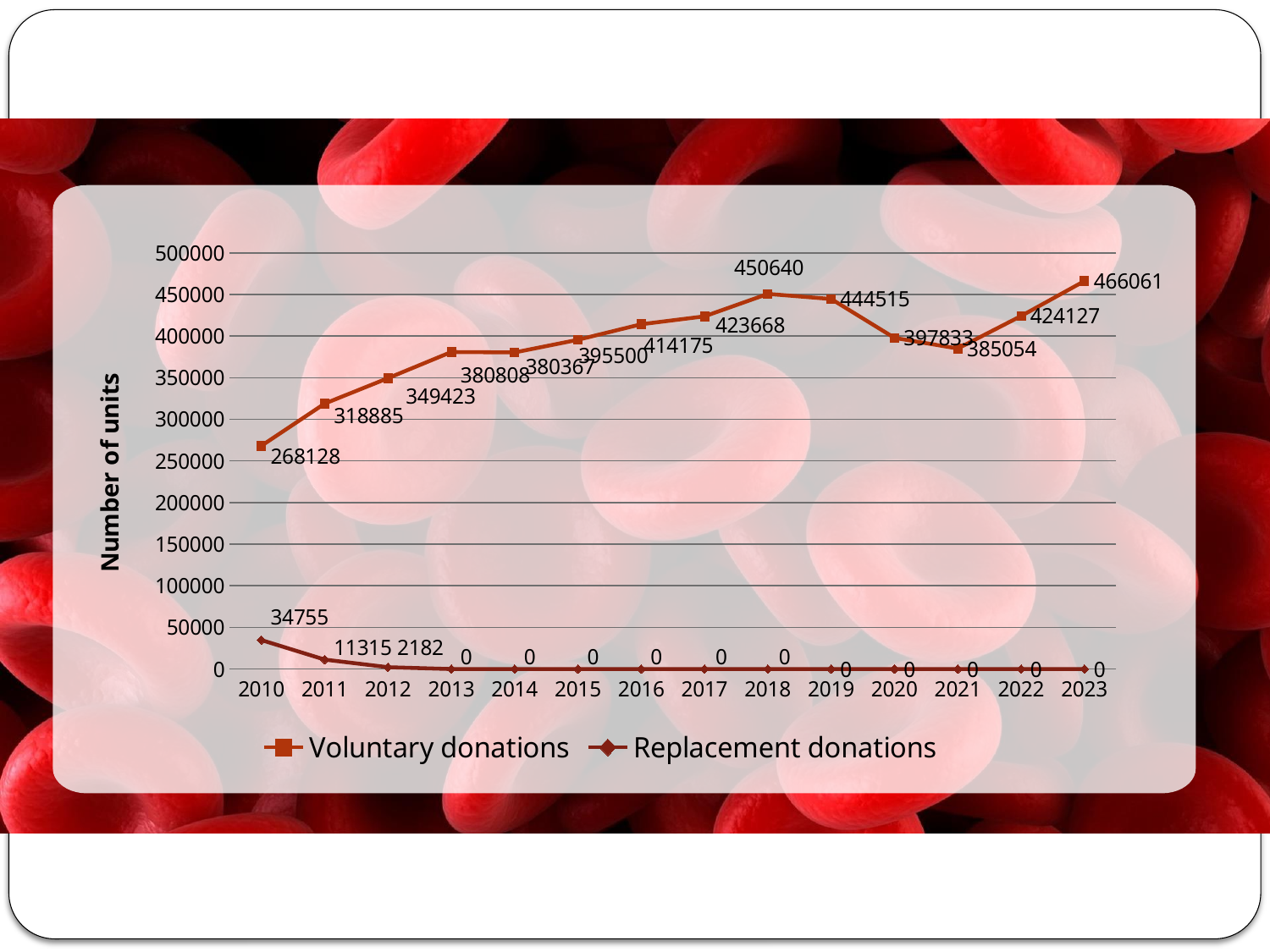
What kind of chart is shown on the slide? Line chart What is the value for Voluntary donations in 2020? 397833 How many years are shown on the x axis? 14 How many series does the legend list? 2 Is the value for Voluntary donations in 2016 greater or less than 400000? greater In which year are Voluntary donations highest? 2023 In which year are Voluntary donations lowest? 2010 What is the value for Replacement donations in 2010? 34755 What is the difference between Voluntary donations in 2023 and in 2010? 197933 What is the value for Voluntary donations in 2018? 450640 Which is larger, Voluntary donations in 2019 or in 2022? 2019 What is the title of the vertical axis? Number of units